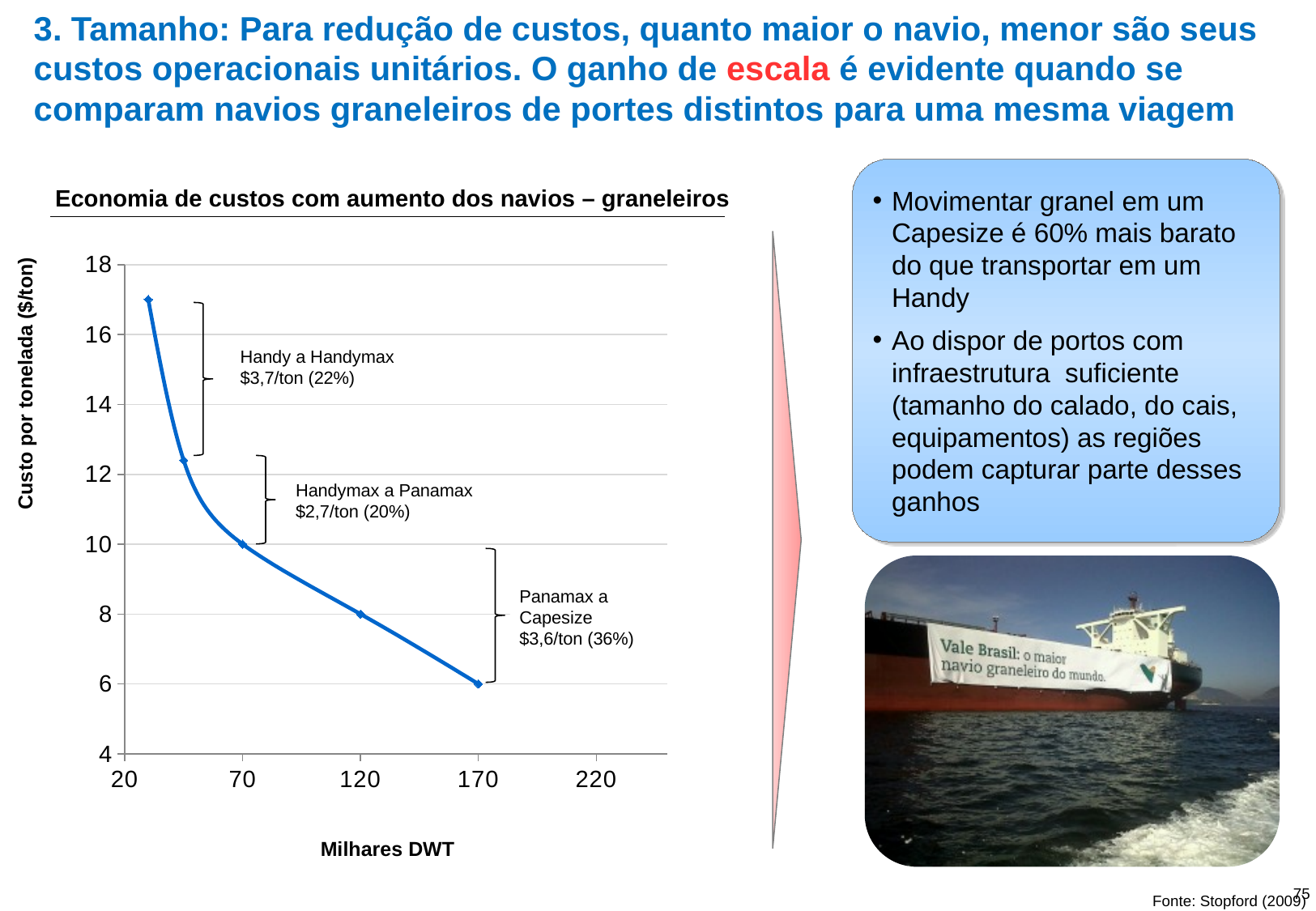
According to the chart annotation, what is the cost saving per tonne from Handy to Handymax? $3,7/ton (22%) Which of the three annotated size steps shows the largest percentage cost saving? Panamax a Capesize (36%) What kind of chart is shown under the title 'Economia de custos com aumento dos navios – graneleiros'? line chart How many data points are plotted on the line in the chart? 5 Which of the three annotated size steps shows the smallest cost saving in $/ton? Handymax a Panamax ($2,7/ton) Which has a higher cost per tonne: the ship at 70 thousand DWT or the ship at 170 thousand DWT? 70 thousand DWT According to the chart annotation, what is the cost saving per tonne from Handymax to Panamax? $2,7/ton (20%) According to the chart annotation, what is the cost saving per tonne from Panamax to Capesize? $3,6/ton (36%) Is the cost per tonne at 120 thousand DWT greater or less than 10 $/ton? less Does the cost per tonne rise or fall as the ship size (Milhares DWT) increases along the x axis? fall Is the cost per tonne at 170 thousand DWT greater or less than 8 $/ton? less What is the title of the vertical axis of the chart? Custo por tonelada ($/ton)